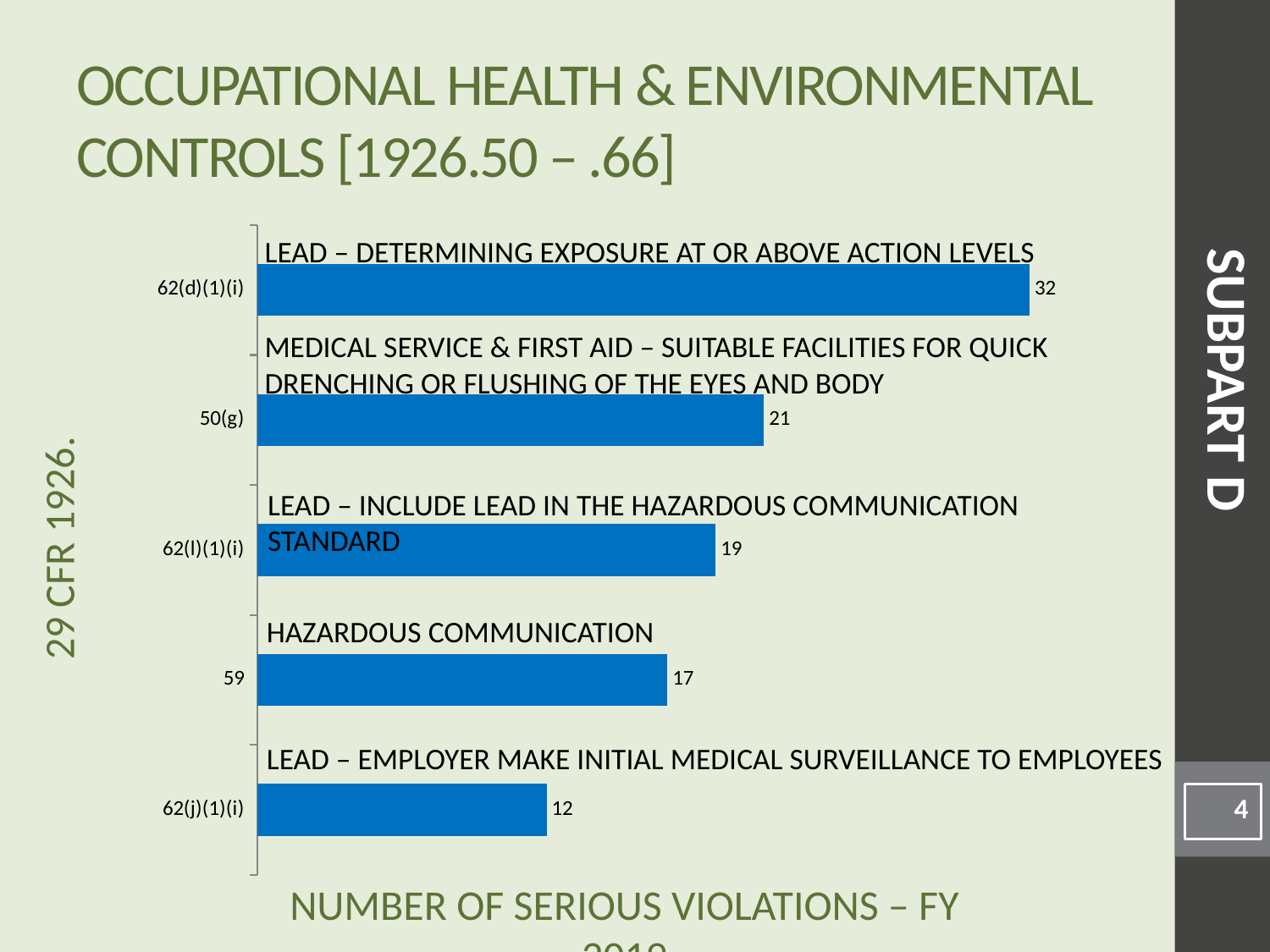
What is the number of serious violations for 62(d)(1)(i)? 32 What is the number of serious violations for 62(l)(1)(i)? 19 What is the total number of serious violations across all five categories? 101 What is the number of serious violations for 62(j)(1)(i)? 12 Which category has the lowest number of serious violations? 62(j)(1)(i) What type of chart is shown on the slide? Bar chart Which has more serious violations, 50(g) or 59? 50(g) What is the number of serious violations for 59 (Hazardous Communication)? 17 Which category has the highest number of serious violations? 62(d)(1)(i) What is the number of serious violations for 50(g)? 21 What is the difference in serious violations between 62(d)(1)(i) and 62(j)(1)(i)? 20 How many categories are shown in the chart? 5